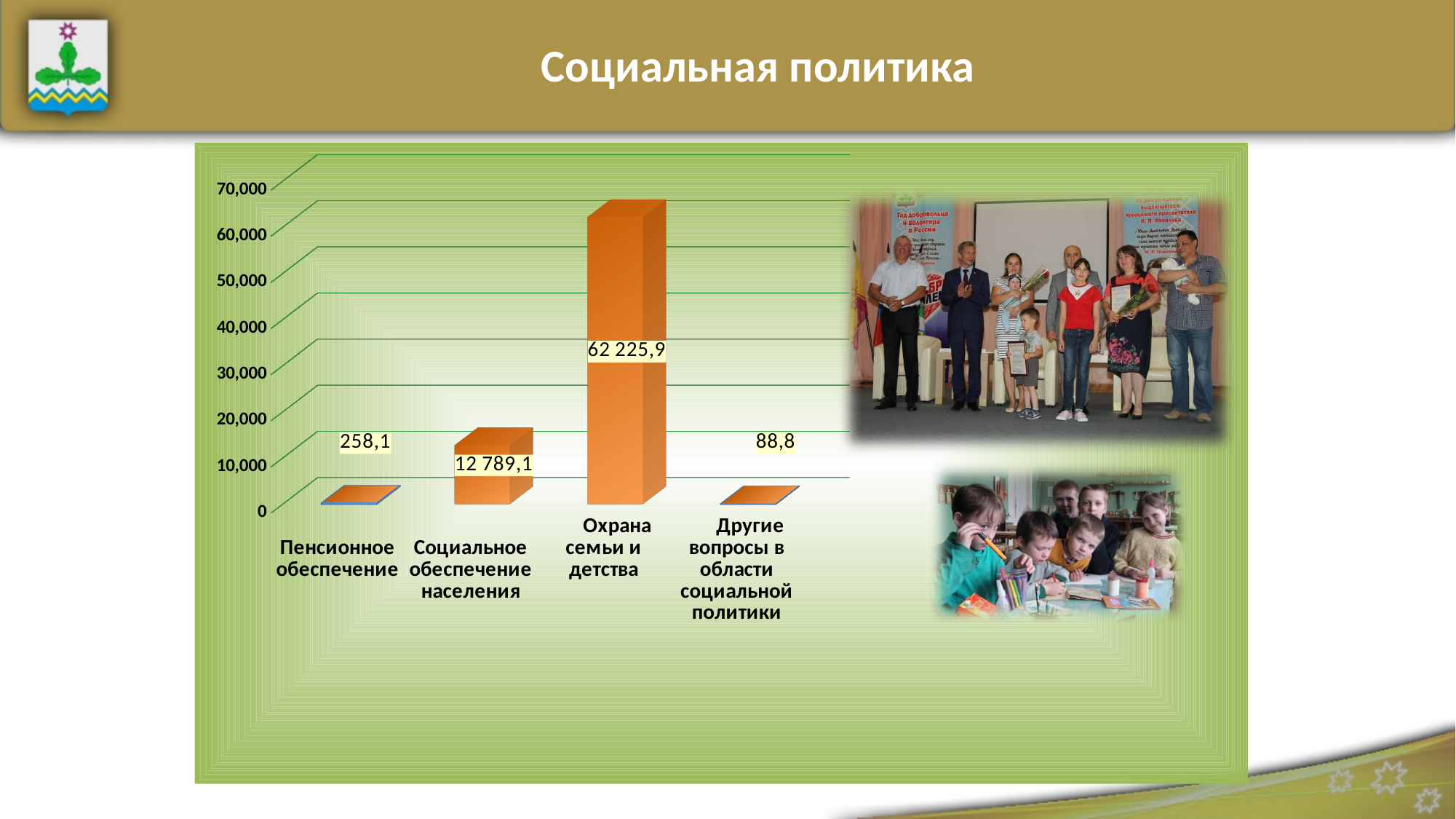
Which category has the lowest value? Другие вопросы в области социальной политики What is the value for Социальное обеспечение населения? 12 789,1 What is the value for Охрана семьи и детства? 62 225,9 What is the difference between the values for Охрана семьи и детства and Социальное обеспечение населения? 49 436,8 Which category has the highest value? Охрана семьи и детства Is the value for Охрана семьи и детства greater or less than 60,000? greater How many categories are shown in the chart? 4 What is the difference between the values for Пенсионное обеспечение and Другие вопросы в области социальной политики? 169,3 Which is larger, the value for Пенсионное обеспечение or the value for Другие вопросы в области социальной политики? Пенсионное обеспечение What is the value for Другие вопросы в области социальной политики? 88,8 What is the value for Пенсионное обеспечение? 258,1 What kind of chart is shown on the slide? bar chart